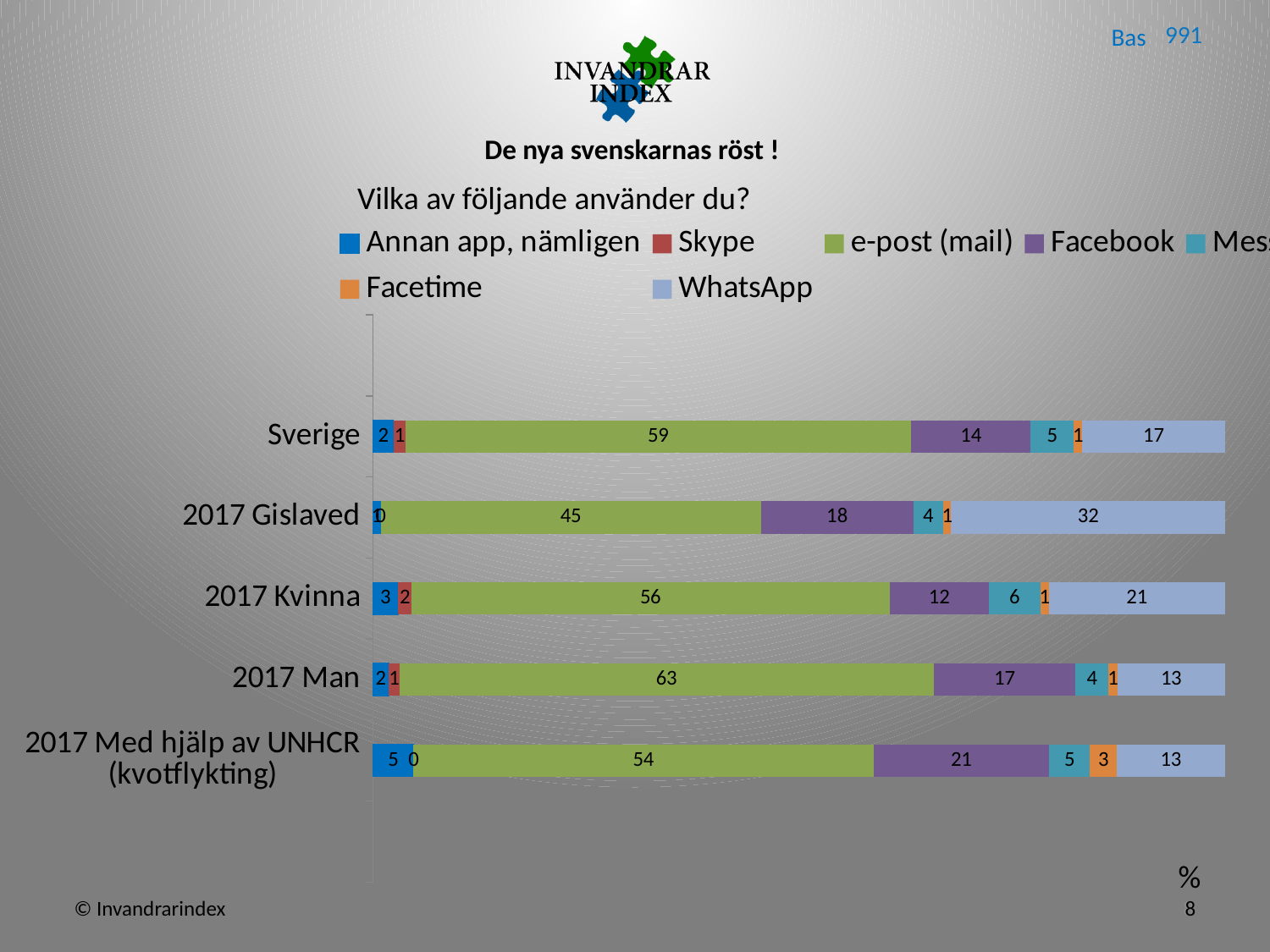
What is the difference between the e-post (mail) values for 2017 Man and 2017 Kvinna? 7 Which has the larger Facebook value, Sverige or 2017 Gislaved? 2017 Gislaved What kind of chart is shown on the slide? Stacked bar chart What is the total of the Sverige bar? 99 How many categories (bars) are shown in the chart? 5 What is the WhatsApp value for 2017 Gislaved? 32 What is the value for e-post (mail) in the Sverige bar? 59 How many series does the legend list? 7 What is the question shown as the chart title? Vilka av följande använder du? Which category has the highest e-post (mail) value? 2017 Man What is the Facebook value for 2017 Med hjälp av UNHCR (kvotflykting)? 21 Which category has the highest WhatsApp value? 2017 Gislaved